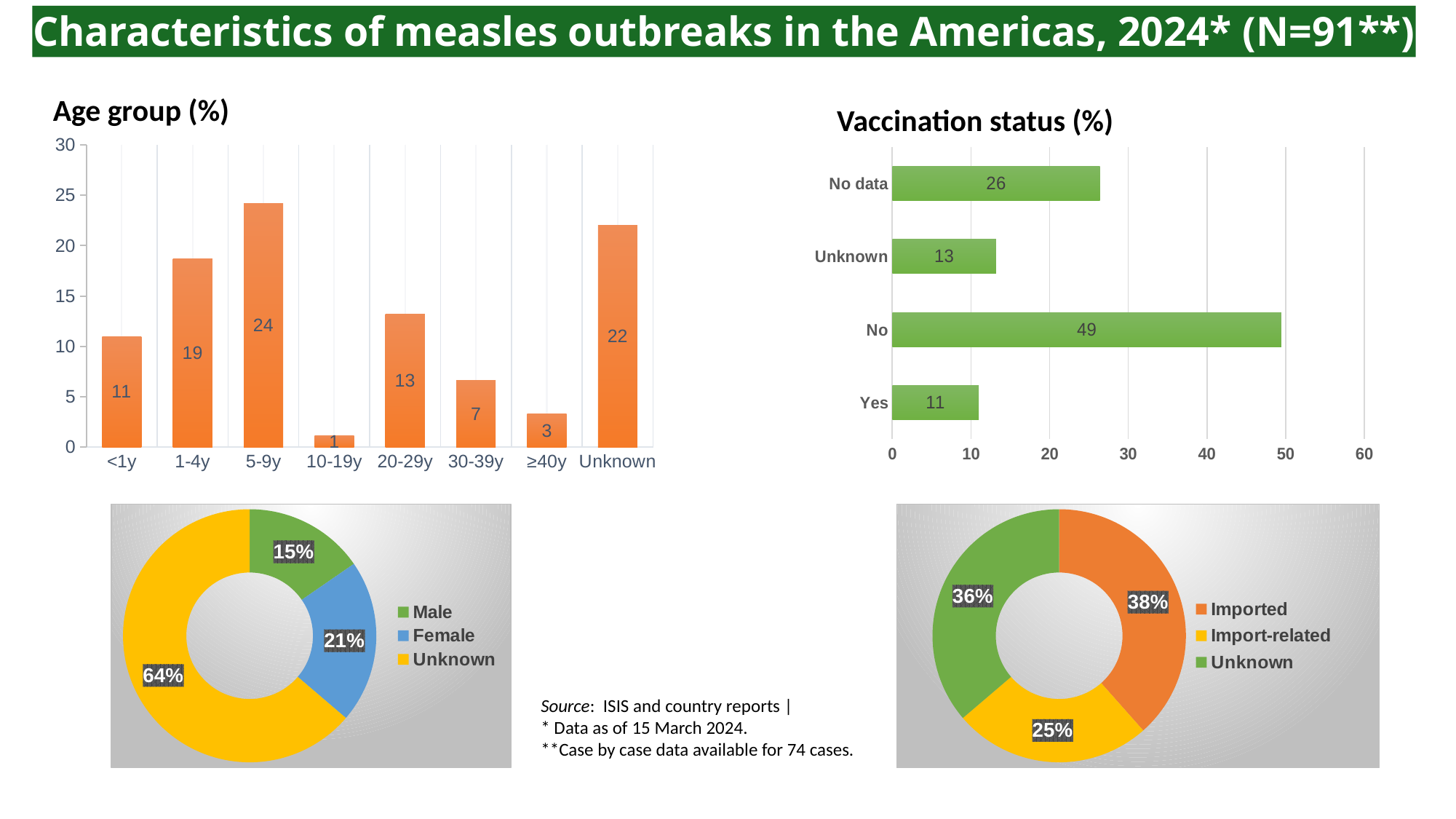
In the bottom-left doughnut chart, what share is Female? 21% In the 'Vaccination status (%)' chart, which category has the highest value? No In the 'Vaccination status (%)' chart, what is the value for 'No'? 49 What kind of chart is the 'Vaccination status (%)' chart? Bar chart In the 'Age group (%)' chart, how many age group categories are shown? 8 In the 'Vaccination status (%)' chart, which is larger, the value for 'No data' or the value for 'Unknown'? No data In the 'Age group (%)' chart, what is the value for the 5-9y age group? 24 In the bottom-left doughnut chart, which category has the largest share? Unknown In the 'Age group (%)' chart, what is the difference between the values for 1-4y and 30-39y? 12 How many entries does the legend of the bottom-right doughnut chart list? 3 In the 'Age group (%)' chart, which age group has the lowest value? 10-19y In the bottom-right doughnut chart, what share is Import-related? 25%